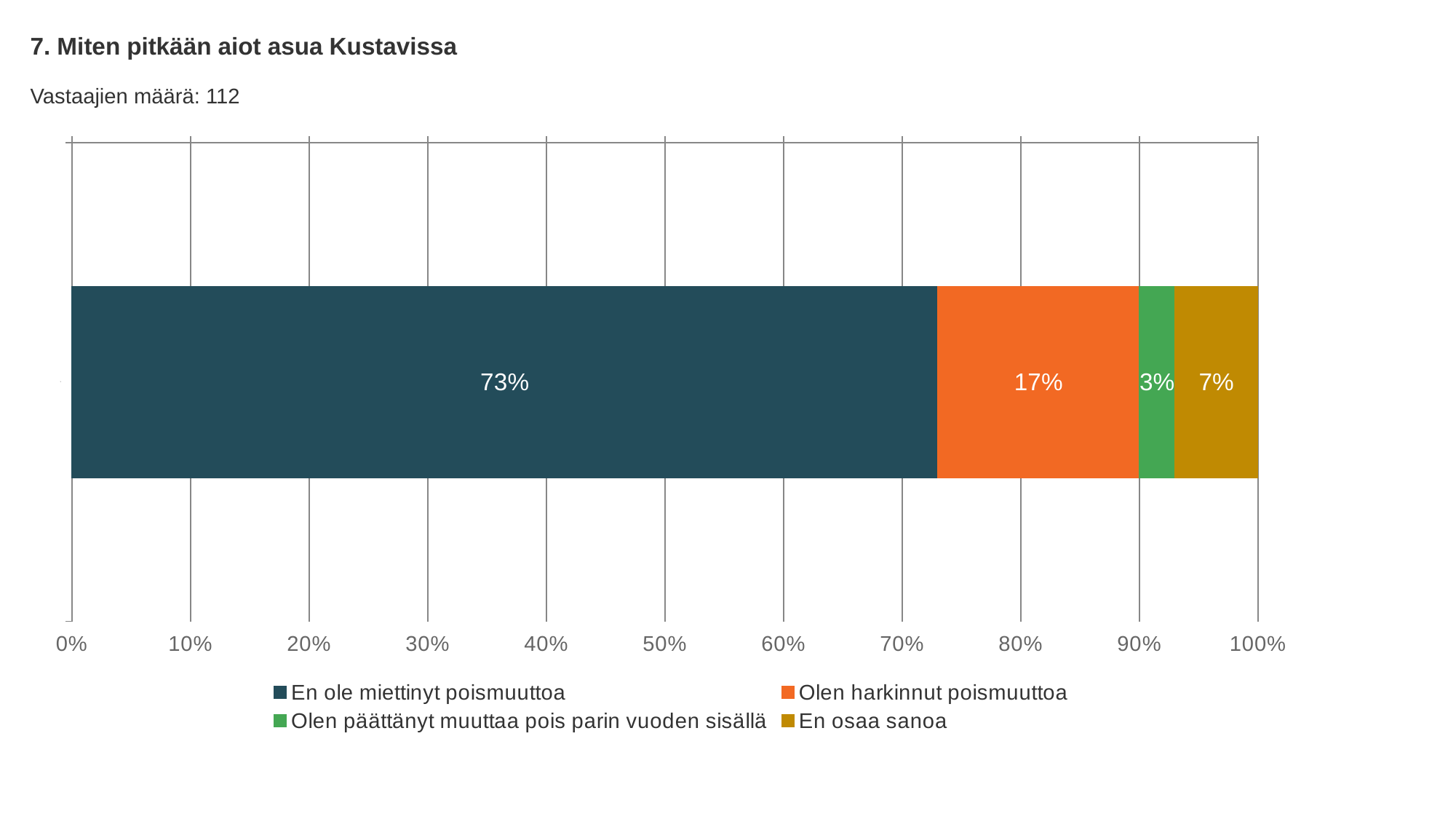
How many series does the legend list? 4 Which response option has the smallest share? Olen päättänyt muuttaa pois parin vuoden sisällä Which is larger, the share for "En osaa sanoa" or for "Olen päättänyt muuttaa pois parin vuoden sisällä"? En osaa sanoa What is the difference in percentage points between "En ole miettinyt poismuuttoa" and "Olen harkinnut poismuuttoa"? 56 What percentage of respondents answered "Olen päättänyt muuttaa pois parin vuoden sisällä"? 3% What is the total of the stacked bar? 100% What percentage of respondents answered "En osaa sanoa"? 7% What percentage of respondents answered "En ole miettinyt poismuuttoa"? 73% What percentage of respondents answered "Olen harkinnut poismuuttoa"? 17% Which response option has the largest share? En ole miettinyt poismuuttoa What kind of chart is shown on the slide? Stacked bar chart How many respondents (Vastaajien määrä) are reported on the slide? 112